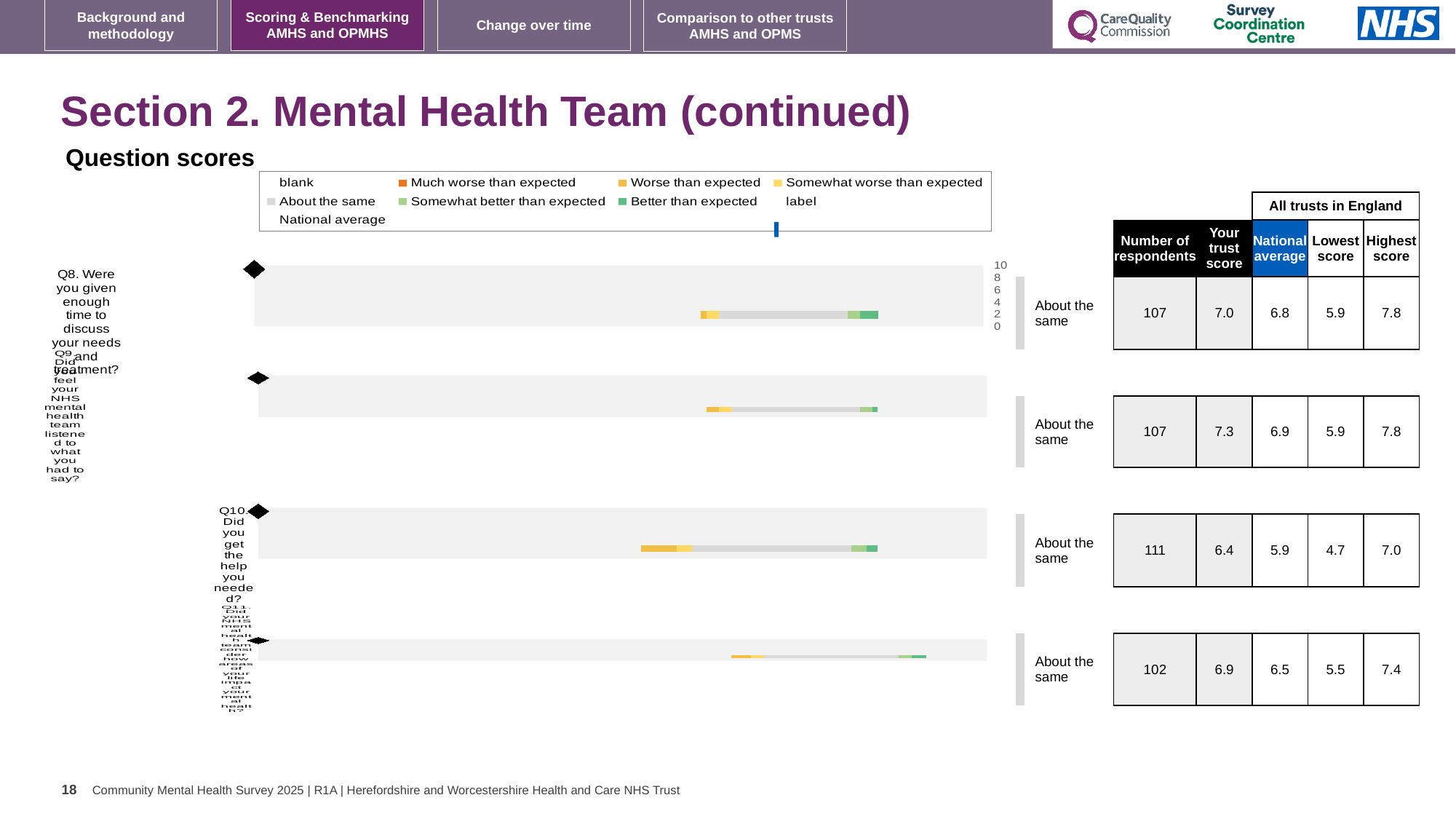
What is the difference between the trust score and the national average for Q9? 0.4 In the table beside the charts, what is the lowest score across all trusts in England for Q10? 4.7 In the chart legend, what colour represents 'Better than expected'? green In the table beside the charts, what is the number of respondents for Q8? 107 In the chart legend, what colour represents 'Much worse than expected'? orange In the table beside the charts, what is the trust's score for Q10 (Did you get the help you needed?)? 6.4 In the table beside the charts, what is the national average for Q11? 6.5 How many questions (Q8 to Q11) have a bar chart on this slide? 4 Which question has the highest 'Your trust score' in the table beside the charts? Q9 For Q8, which is larger: the trust score or the national average? the trust score Which question has the lowest 'Your trust score' in the table beside the charts? Q10 What kind of chart is used to show the question scores on this slide? bar chart